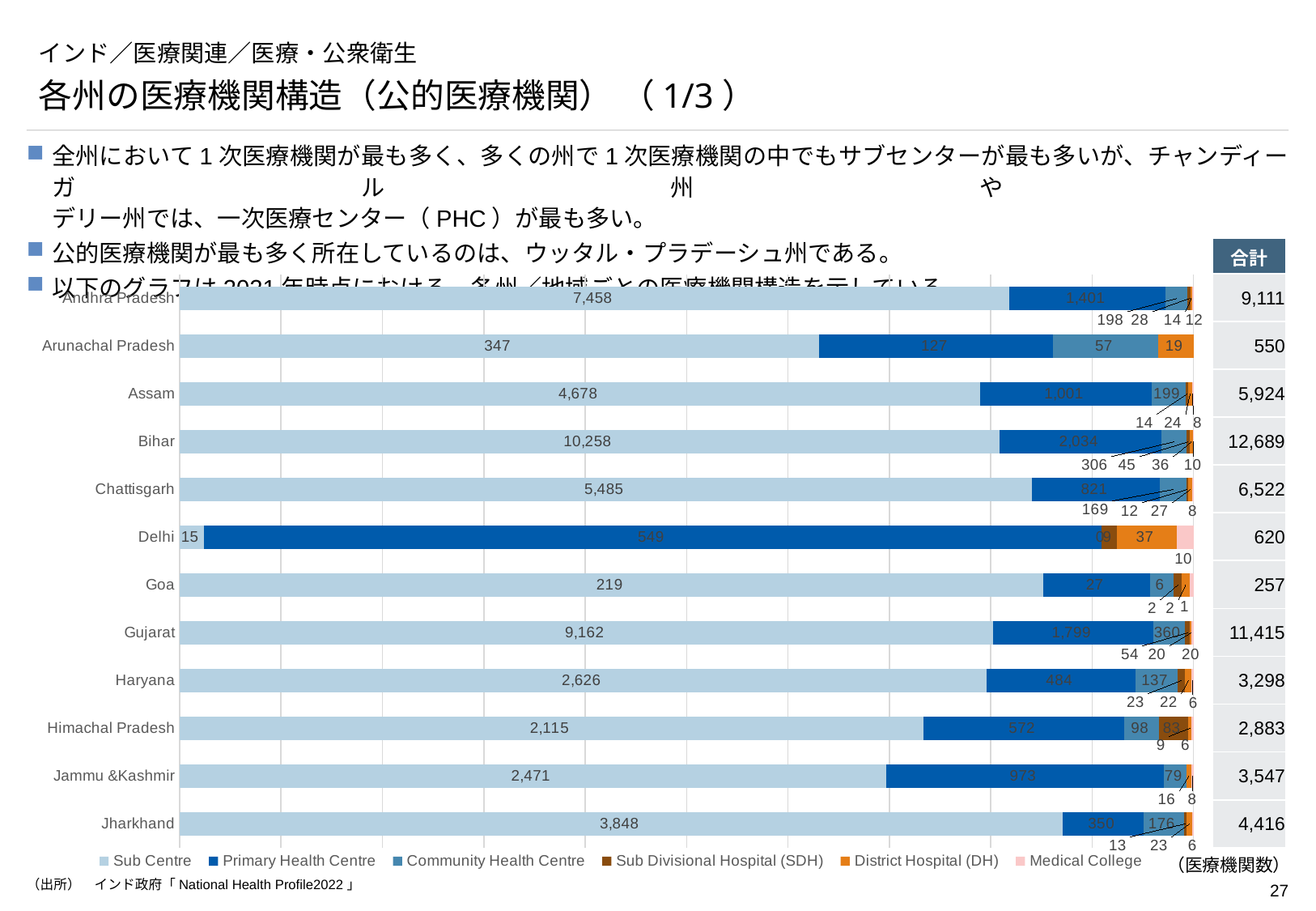
Which state has the highest total (合計) number of facilities? Bihar Which state has the lowest total (合計) number of facilities? Goa What is the difference between the Sub Centre values for Bihar and Andhra Pradesh? 2,800 What is the Sub Centre value for Delhi? 15 What is the Primary Health Centre value for Gujarat? 1,799 What is the District Hospital (DH) value for Arunachal Pradesh? 19 How many series does the legend list? 6 What is the Sub Centre value for Bihar? 10,258 What kind of chart is shown on the slide? Stacked bar chart Which has a larger Sub Centre value, Andhra Pradesh or Gujarat? Gujarat What is the total (合計) for Gujarat? 11,415 How many states are shown in the chart? 12